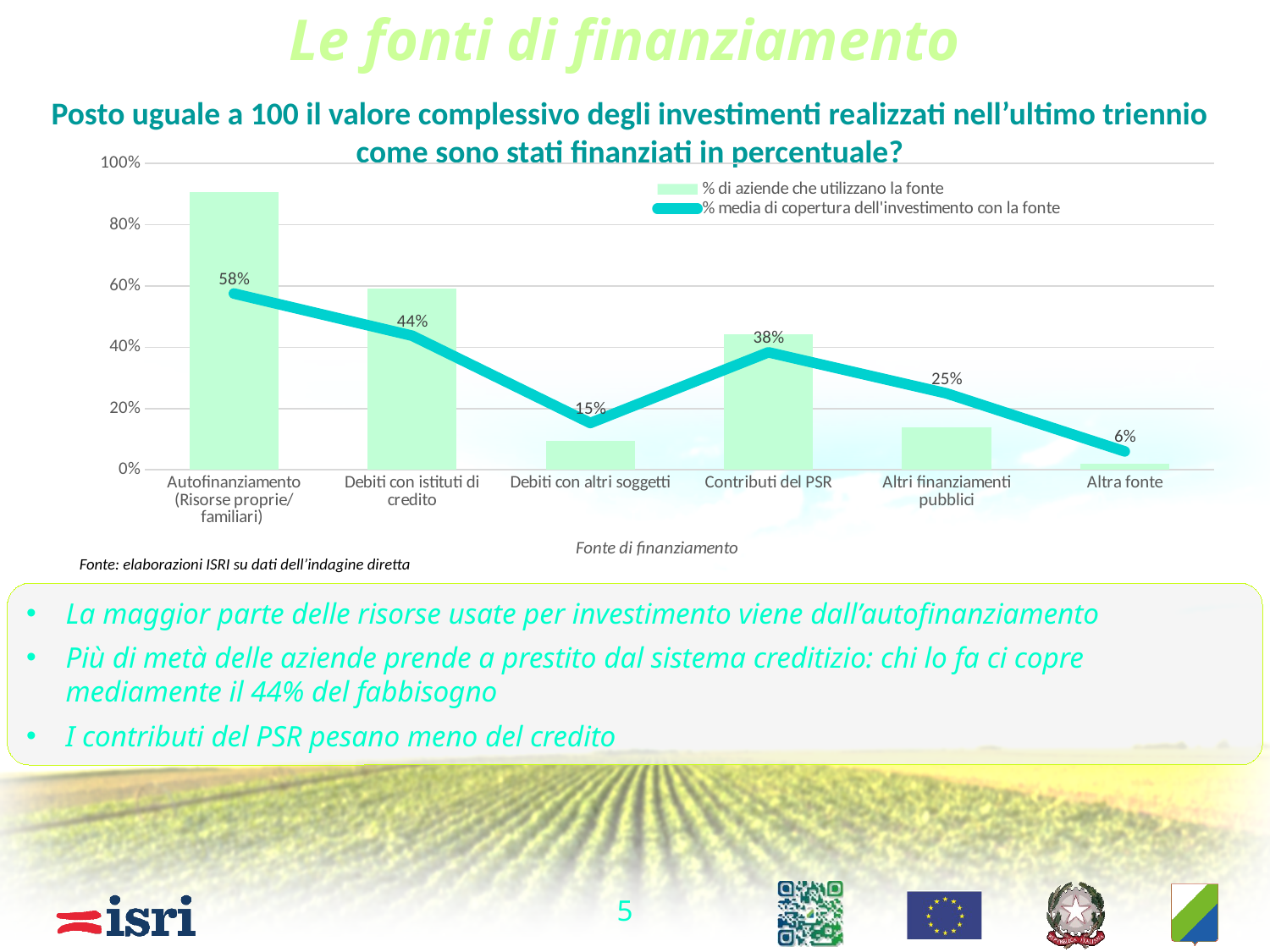
What is the '% media di copertura dell'investimento con la fonte' value for Autofinanziamento? 58% What is the '% media di copertura dell'investimento con la fonte' value for Contributi del PSR? 38% Is the '% di aziende che utilizzano la fonte' bar for Autofinanziamento greater or less than 80%? greater What kinds of chart are combined on this slide? A bar chart and a line chart What is the '% media di copertura dell'investimento con la fonte' value for Debiti con istituti di credito? 44% How many series does the legend list? 2 How many financing sources are shown on the x axis? 6 Which financing source has the lowest '% media di copertura dell'investimento con la fonte'? Altra fonte What is the difference between the '% media di copertura' values for Debiti con istituti di credito and Debiti con altri soggetti? 29% Which has a higher '% media di copertura dell'investimento con la fonte': Contributi del PSR or Altri finanziamenti pubblici? Contributi del PSR Which financing source has the highest '% media di copertura dell'investimento con la fonte'? Autofinanziamento (Risorse proprie/familiari) Is the '% di aziende che utilizzano la fonte' bar for Debiti con altri soggetti greater or less than 20%? less